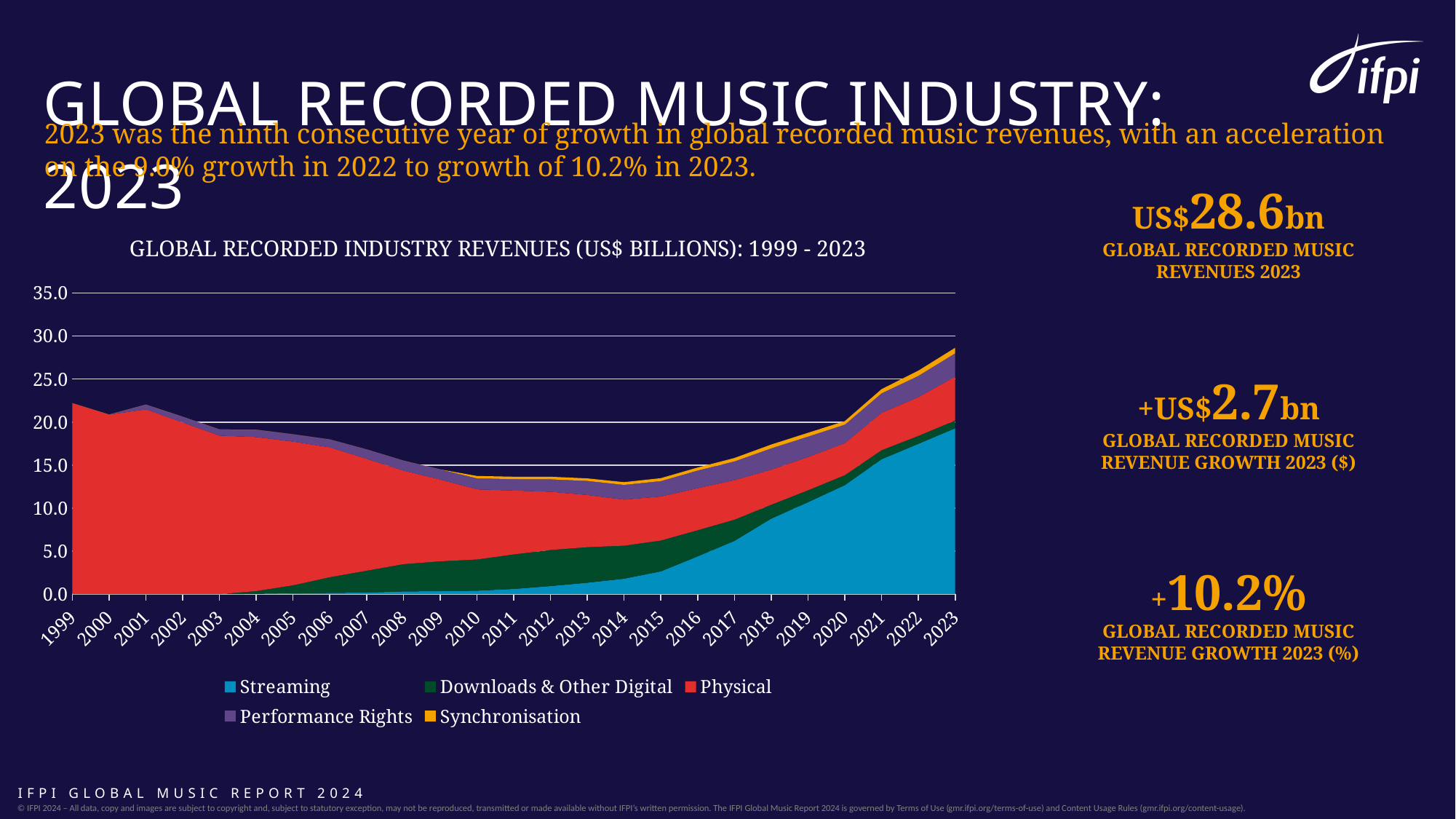
Is the total revenue for 2014 greater or less than 15.0? less Do total revenues rise or fall from 2015 to 2023? Rise How many series does the chart legend list? 5 What is the title of the chart? GLOBAL RECORDED INDUSTRY REVENUES (US$ BILLIONS): 1999 - 2023 Is the Streaming revenue for 2023 greater or less than 15.0? greater Is the Physical revenue for 1999 greater or less than 20.0? greater Which series is shown in blue in the chart legend? Streaming In 2023, which is larger: Streaming revenue or Physical revenue? Streaming How many years are shown along the x axis of the chart? 25 In which year is the total recorded music revenue highest? 2023 What kind of chart is shown on the slide? Stacked area chart